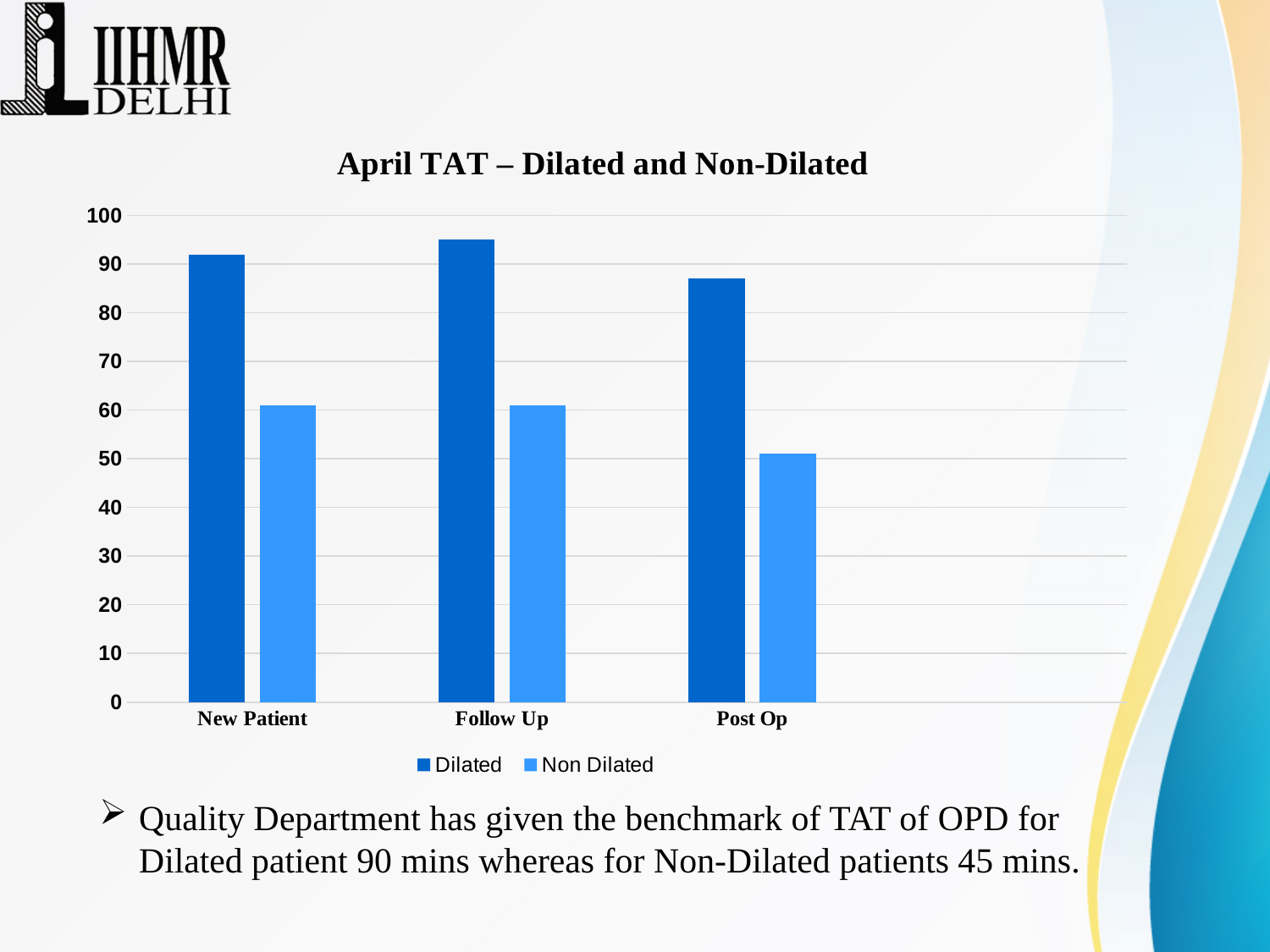
How many categories are shown on the x axis? 3 Which category has the lowest Dilated value? Post Op What kind of chart is shown on the slide? Bar chart What is the title of the chart? April TAT – Dilated and Non-Dilated Is the Non Dilated value for New Patient greater or less than 50? greater How many series does the legend list? 2 Is the Dilated value for Follow Up greater or less than 90? greater For Post Op, which is larger: the Dilated value or the Non Dilated value? Dilated Which series is shown in the lighter blue colour? Non Dilated Is the Dilated value for Post Op greater or less than 90? less Which category has the lowest Non Dilated value? Post Op